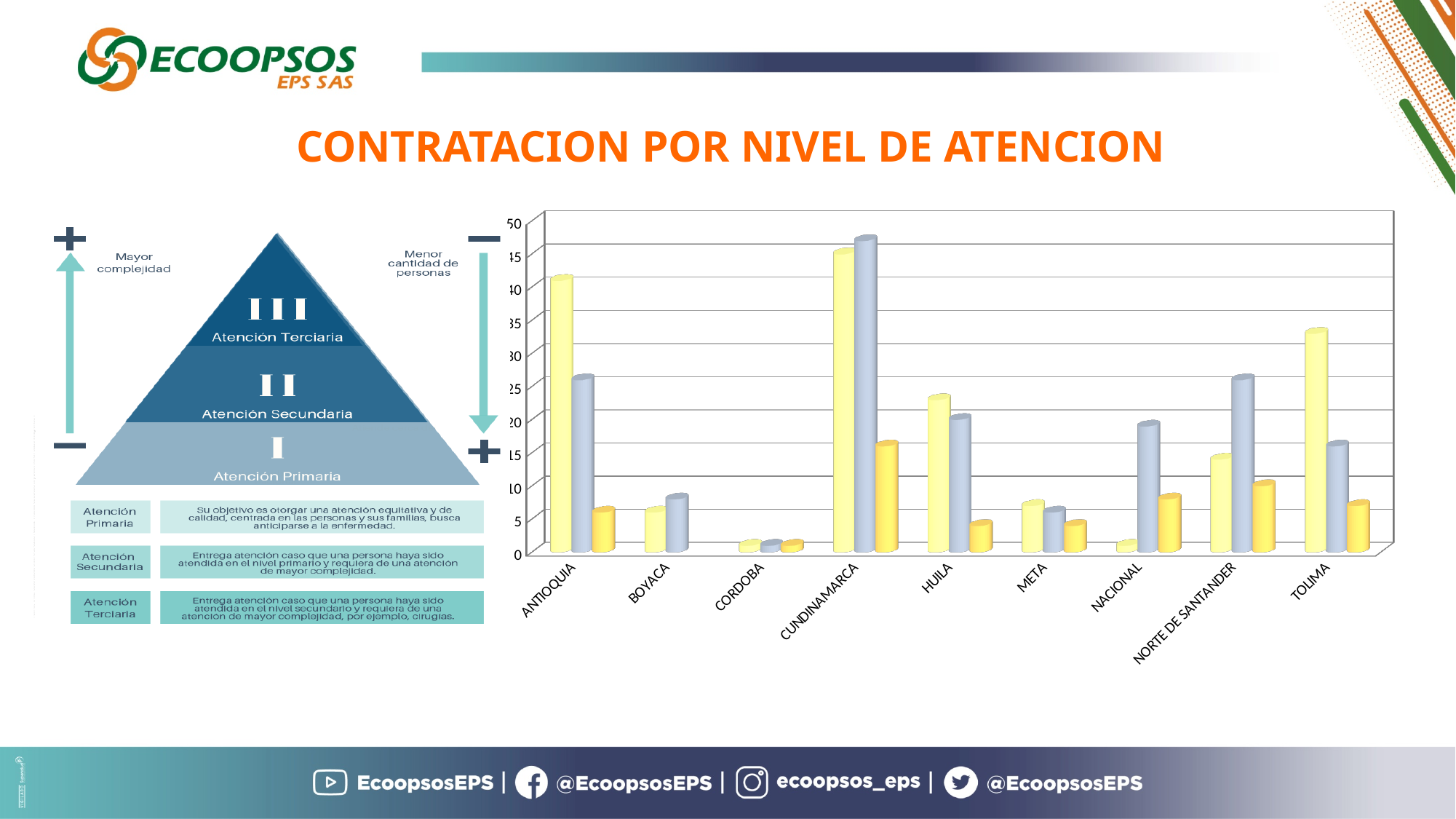
For ANTIOQUIA, which is larger: the yellow bar or the blue-grey bar? the yellow bar Which category has the tallest yellow bar? CUNDINAMARCA Is the yellow bar for TOLIMA greater or less than 30? greater What is the title of the slide containing the chart? CONTRATACION POR NIVEL DE ATENCION Is the yellow bar for CORDOBA greater or less than 5? less Is the yellow bar for ANTIOQUIA greater or less than 35? greater For NACIONAL, which is larger: the yellow bar or the blue-grey bar? the blue-grey bar Which category has the tallest blue-grey bar? CUNDINAMARCA How many categories are shown on the x axis of the chart? 9 What kind of chart is shown on the slide? bar chart